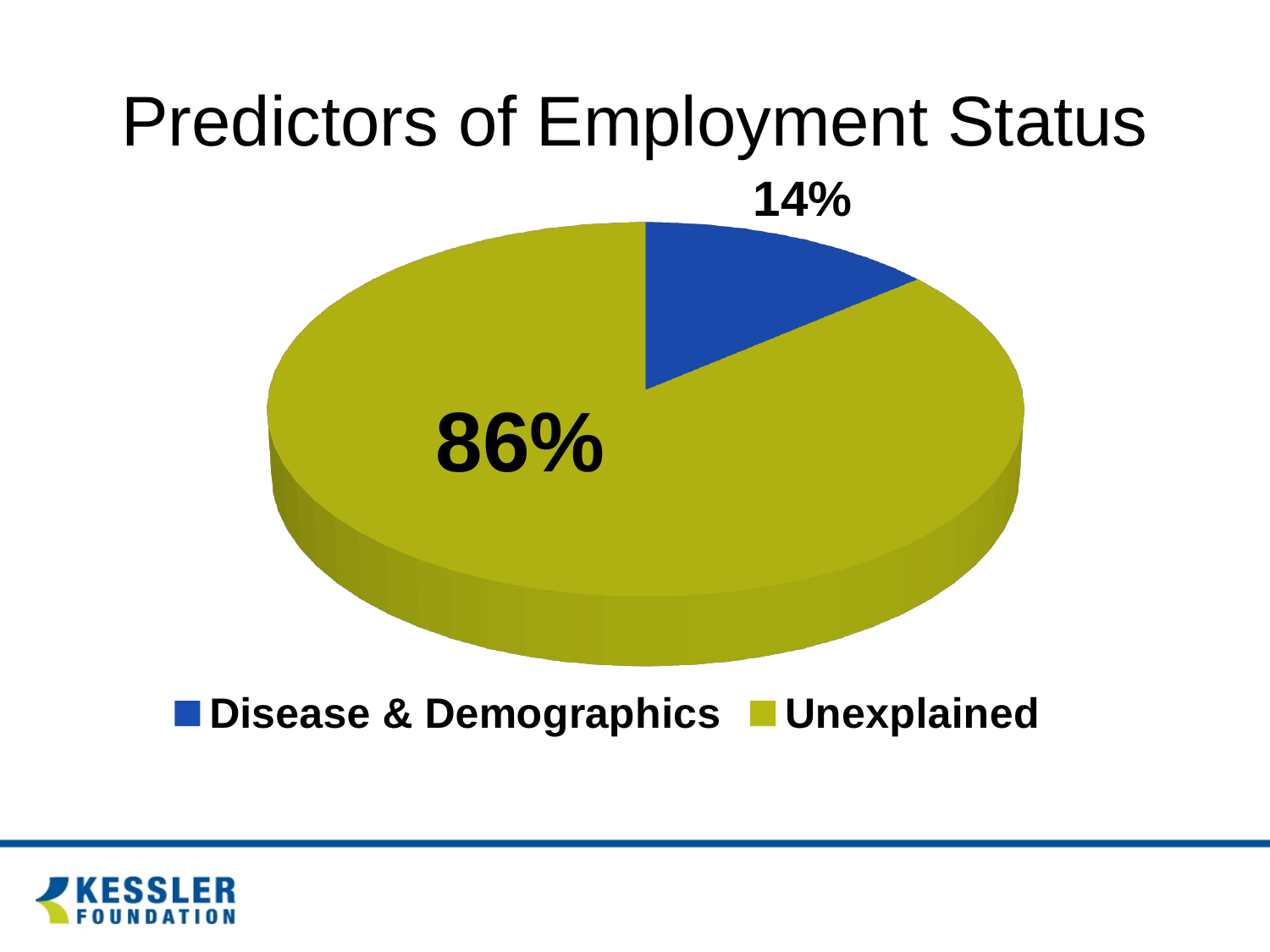
What share of the pie is labelled Disease & Demographics? 14% What is the title of the chart? Predictors of Employment Status Which slice of the pie is the smallest? Disease & Demographics What share of the pie is labelled Unexplained? 86% How many slices does the pie chart have? 2 How many entries does the legend list? 2 What kind of chart is shown on the slide? Pie chart What colour is the Disease & Demographics slice? Blue Which is larger, the Disease & Demographics slice or the Unexplained slice? Unexplained What is the difference in percentage points between the Unexplained slice and the Disease & Demographics slice? 72 What is the total of the two slice percentages shown? 100% Which slice of the pie is the largest? Unexplained